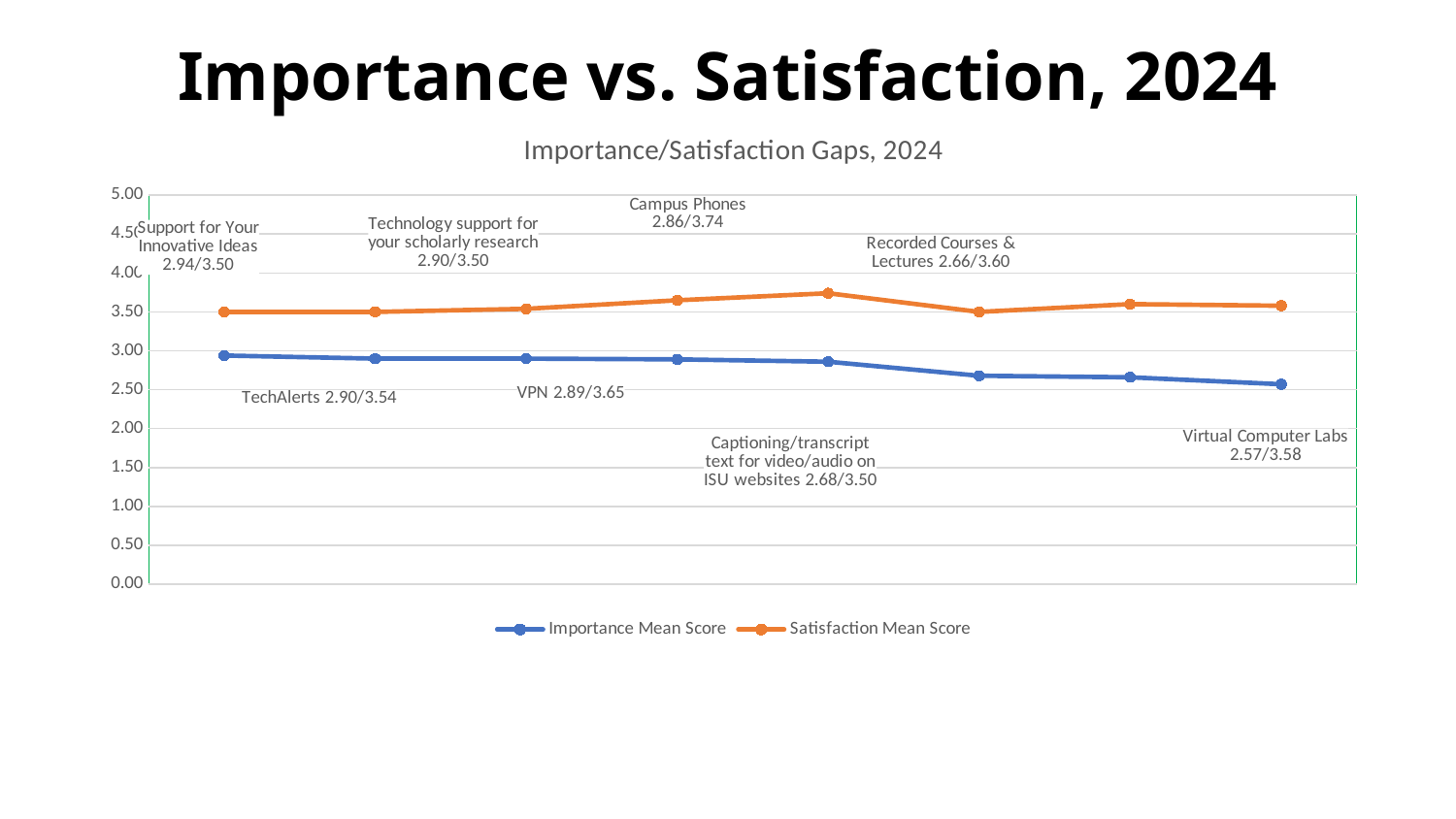
Which item has the highest Satisfaction Mean Score? Campus Phones Does the Importance Mean Score line generally rise or fall from left to right? Fall How many data points are plotted for each series? 8 What is the Satisfaction Mean Score for Campus Phones? 3.74 Which is larger for Recorded Courses & Lectures, the Importance Mean Score or the Satisfaction Mean Score? Satisfaction Mean Score What is the difference between the Satisfaction Mean Score and the Importance Mean Score for Campus Phones? 0.88 How many series does the legend list? 2 What is the Importance Mean Score for VPN? 2.89 What is the title of the chart? Importance/Satisfaction Gaps, 2024 Which item has the lowest Importance Mean Score? Virtual Computer Labs What kind of chart is shown on the slide? Line chart What is the Importance Mean Score for Virtual Computer Labs? 2.57